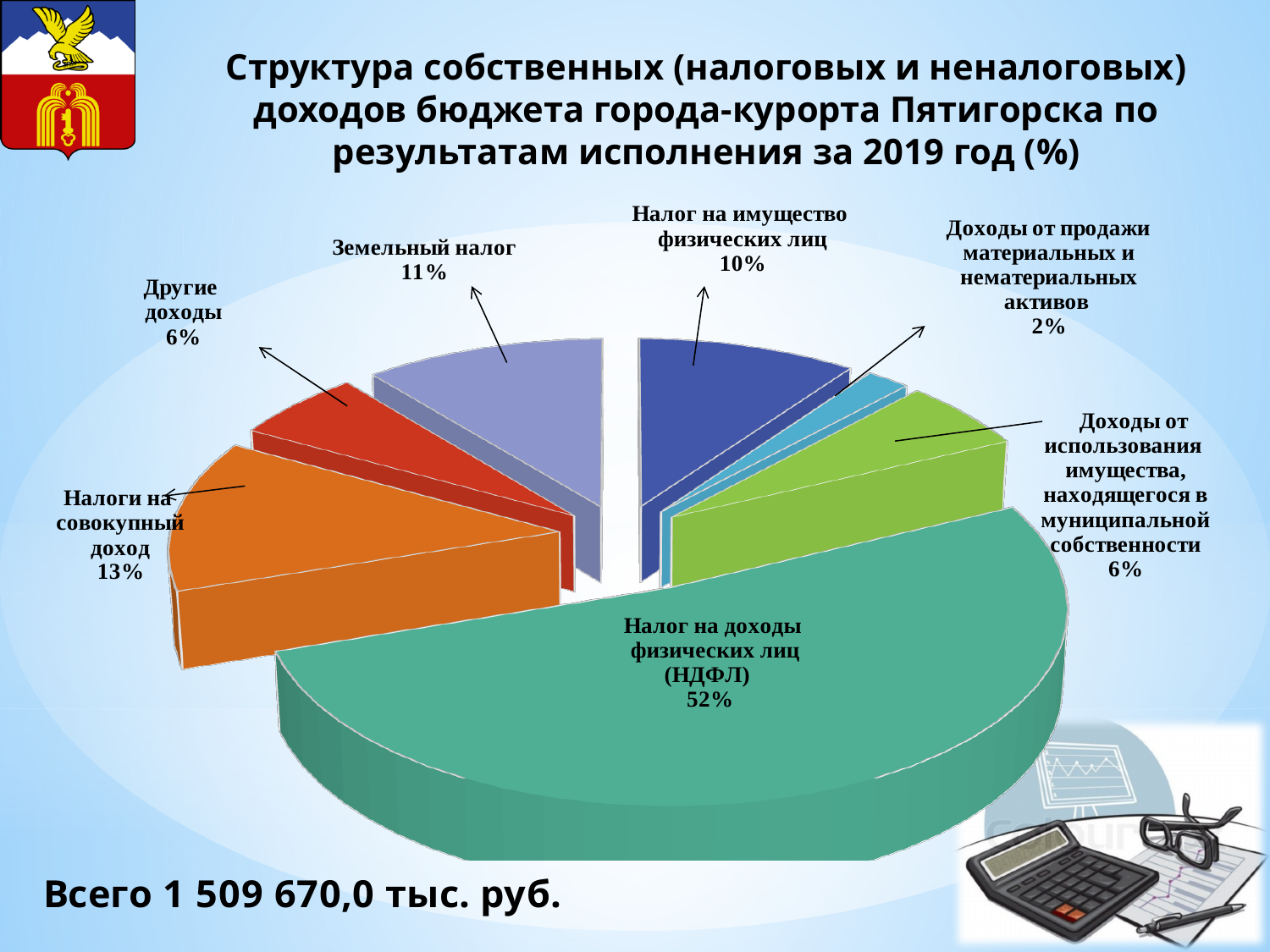
For which year does the chart show the structure of own revenues? 2019 How many categories (slices) does the pie chart have? 7 What share is shown for Доходы от продажи материальных и нематериальных активов? 2% What kind of chart is shown on the slide? Pie chart Which category has the largest share of the pie? Налог на доходы физических лиц (НДФЛ) What share of the budget's own revenues comes from Налог на доходы физических лиц (НДФЛ)? 52% What share is shown for Налоги на совокупный доход? 13% What is the difference in percentage points between Налоги на совокупный доход and Налог на имущество физических лиц? 3 Which is larger: the share for Земельный налог or the share for Налог на имущество физических лиц? Земельный налог What share is shown for Земельный налог? 11% What total amount of own revenues is stated on the slide? 1 509 670,0 тыс. руб. Which category has the smallest share of the pie? Доходы от продажи материальных и нематериальных активов